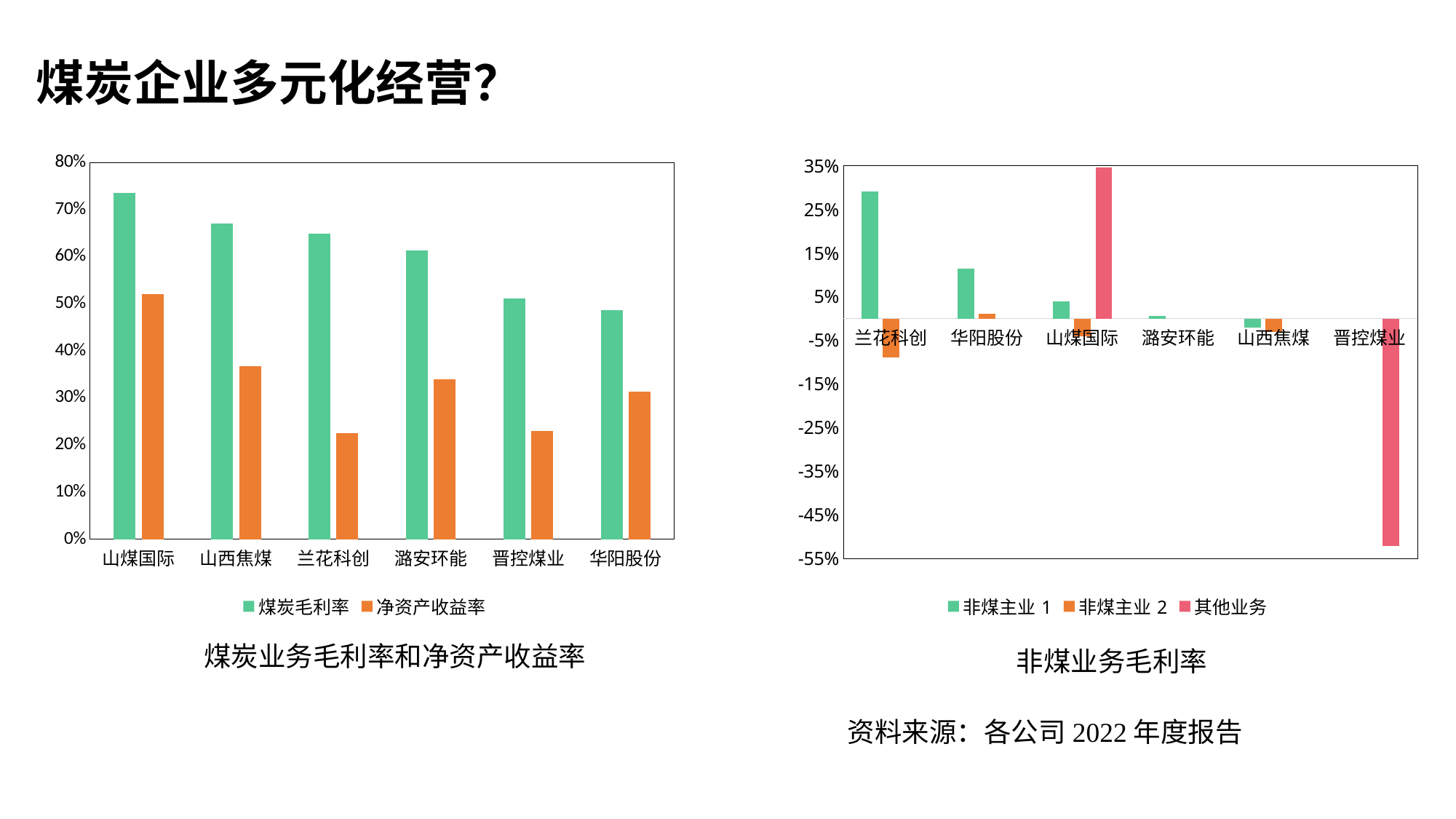
In the left chart (煤炭业务毛利率和净资产收益率), is the 煤炭毛利率 for 山煤国际 greater or less than 70%? greater How many series does the legend of the right chart (非煤业务毛利率) list? 3 In the right chart (非煤业务毛利率), is the 其他业务 value for 山煤国际 greater or less than 25%? greater What kind of chart is the left chart titled 煤炭业务毛利率和净资产收益率? bar chart In the left chart (煤炭业务毛利率和净资产收益率), is the 净资产收益率 for 山西焦煤 greater or less than 40%? less In the left chart (煤炭业务毛利率和净资产收益率), which company has the highest 净资产收益率? 山煤国际 In the left chart (煤炭业务毛利率和净资产收益率), does the 煤炭毛利率 rise or fall from left to right along the x axis? fall In the left chart (煤炭业务毛利率和净资产收益率), which company has the highest 煤炭毛利率? 山煤国际 How many companies are shown on the x axis of the left chart (煤炭业务毛利率和净资产收益率)? 6 In the right chart (非煤业务毛利率), which company has the highest 非煤主业 1 value? 兰花科创 In the left chart (煤炭业务毛利率和净资产收益率), which company has the lowest 煤炭毛利率? 华阳股份